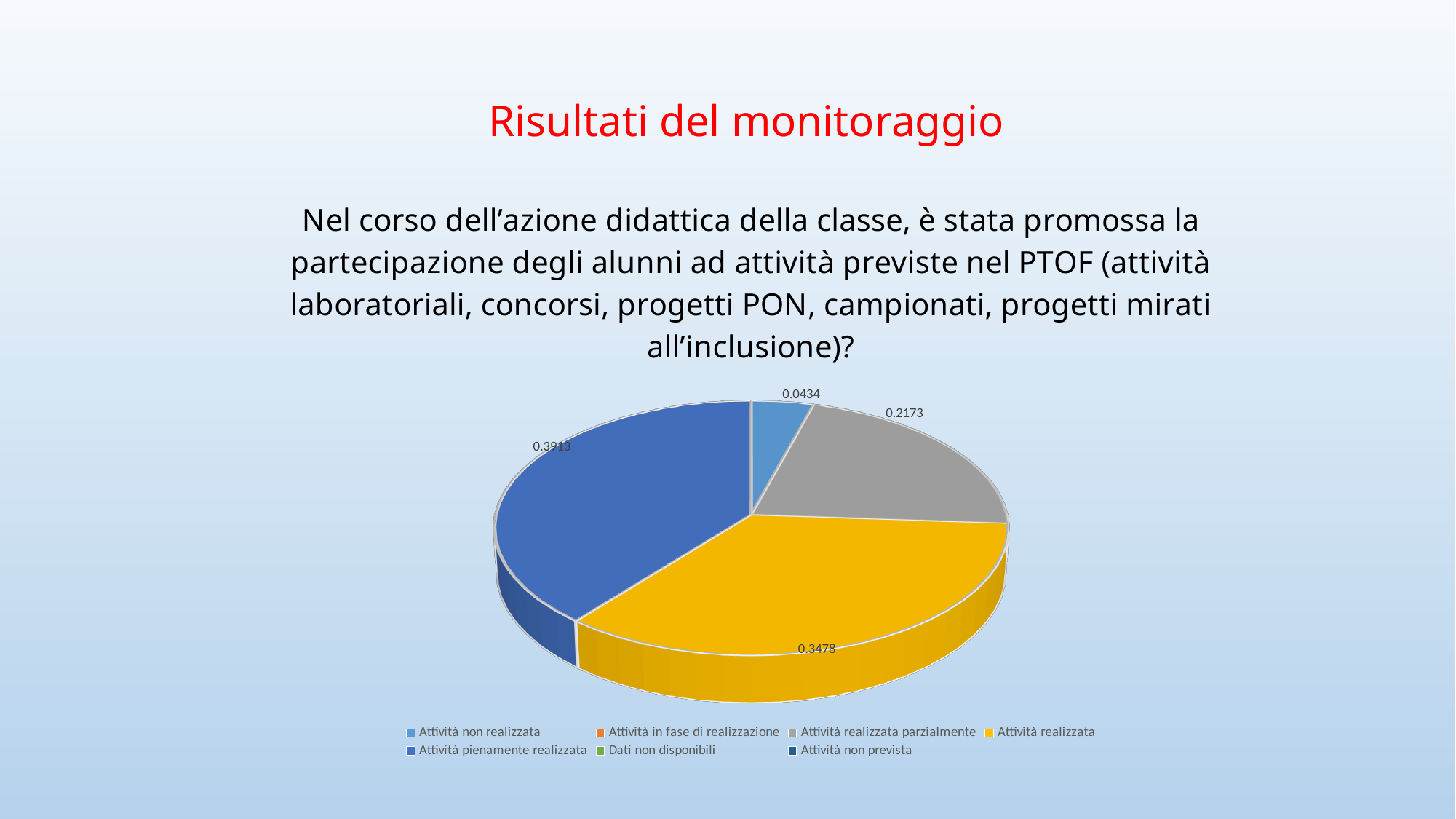
What kind of chart is shown on the slide? pie chart What is the value shown for Attività non realizzata? 0.0434 What is the value shown for Attività realizzata? 0.3478 What is the value shown for Attività realizzata parzialmente? 0.2173 How many slices with data labels are visible in the pie chart? 4 What is the difference between the values for Attività pienamente realizzata and Attività realizzata? 0.0435 Which category has the largest slice of the pie? Attività pienamente realizzata Which category with a visible slice has the smallest value? Attività non realizzata How many entries does the legend list? 7 What colour is the slice for Attività realizzata? yellow Which is larger, the value for Attività realizzata parzialmente or the value for Attività non realizzata? Attività realizzata parzialmente What is the value shown for Attività pienamente realizzata? 0.3913